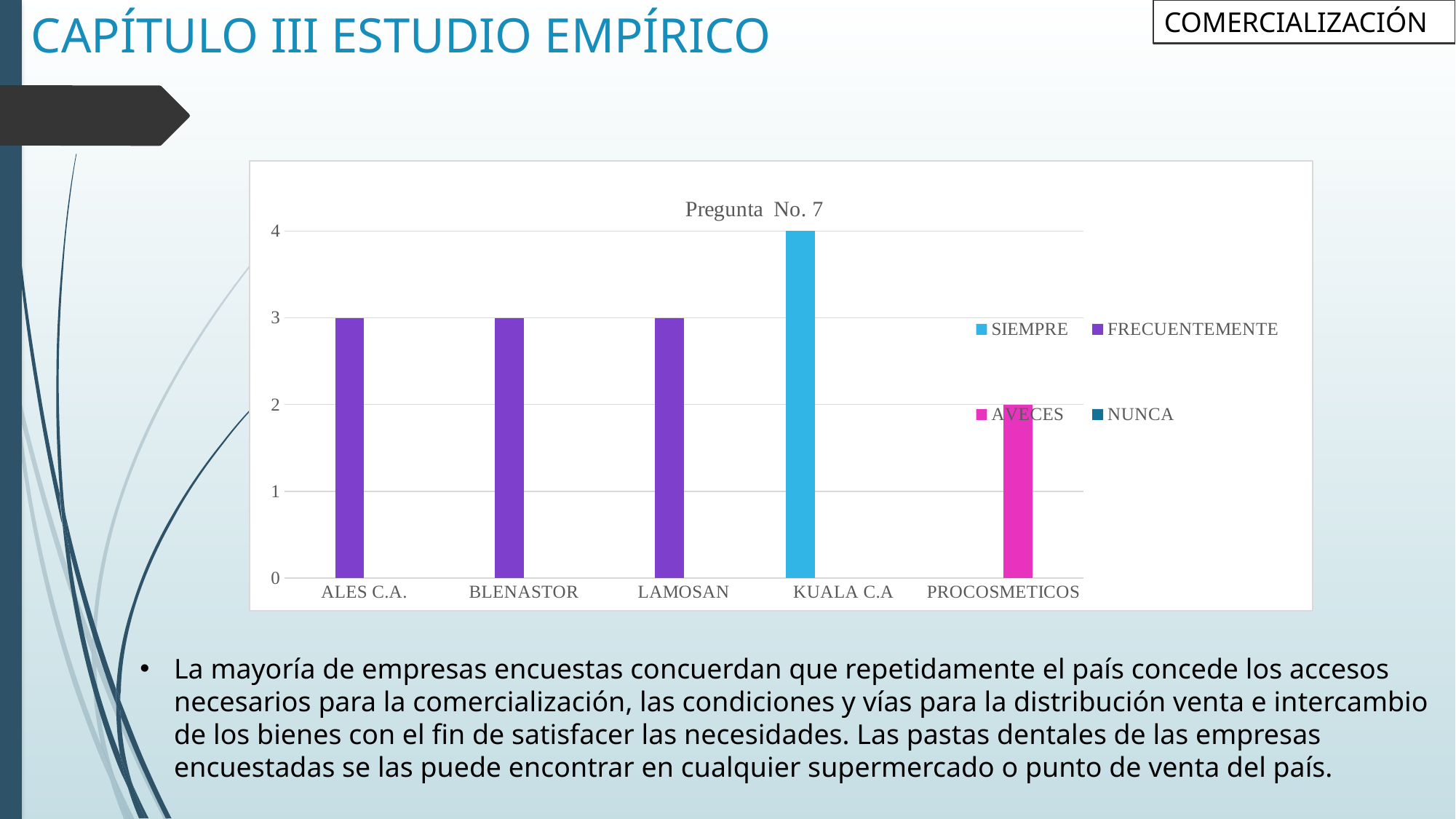
What is the value for PROCOSMETICOS? 2 What kind of chart is shown? bar chart Which legend series does the bar for KUALA C.A belong to? SIEMPRE What is the difference between the values for KUALA C.A and PROCOSMETICOS? 2 What is the value for KUALA C.A? 4 Which is larger, the value for BLENASTOR or the value for PROCOSMETICOS? BLENASTOR What is the value for ALES C.A.? 3 How many companies are shown on the x axis? 5 How many series does the legend list? 4 Which company has the lowest bar? PROCOSMETICOS Which company has the highest bar? KUALA C.A What is the title of the chart? Pregunta No. 7